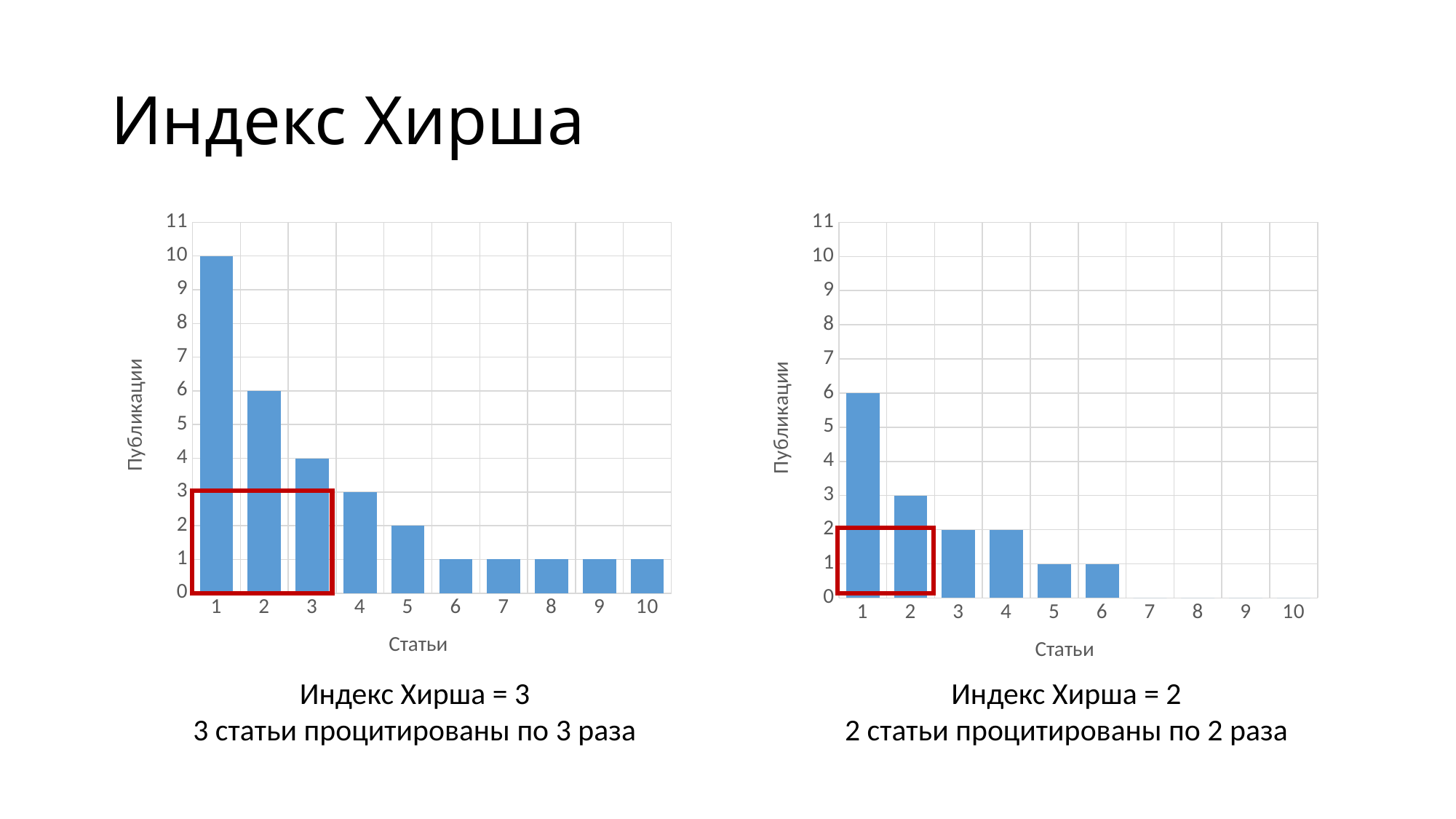
On the right chart, what is the value for article 2? 3 On the right chart, do the values rise or fall from article 1 to article 6? fall On the left chart, what is the value for article 1? 10 What kind of chart is the left chart? bar chart On the right chart, which article has the highest value? 1 On the left chart, how many articles have a bar with a value of 1? 5 On the left chart, what is the value for article 3? 4 On the left chart, what is the difference between the values for article 1 and article 2? 4 On the left chart, which is larger, the value for article 4 or the value for article 5? article 4 On the right chart, how many articles have a visible bar? 6 On the right chart, what is the difference between the values for article 1 and article 3? 4 On the left chart, which article has the highest value? 1